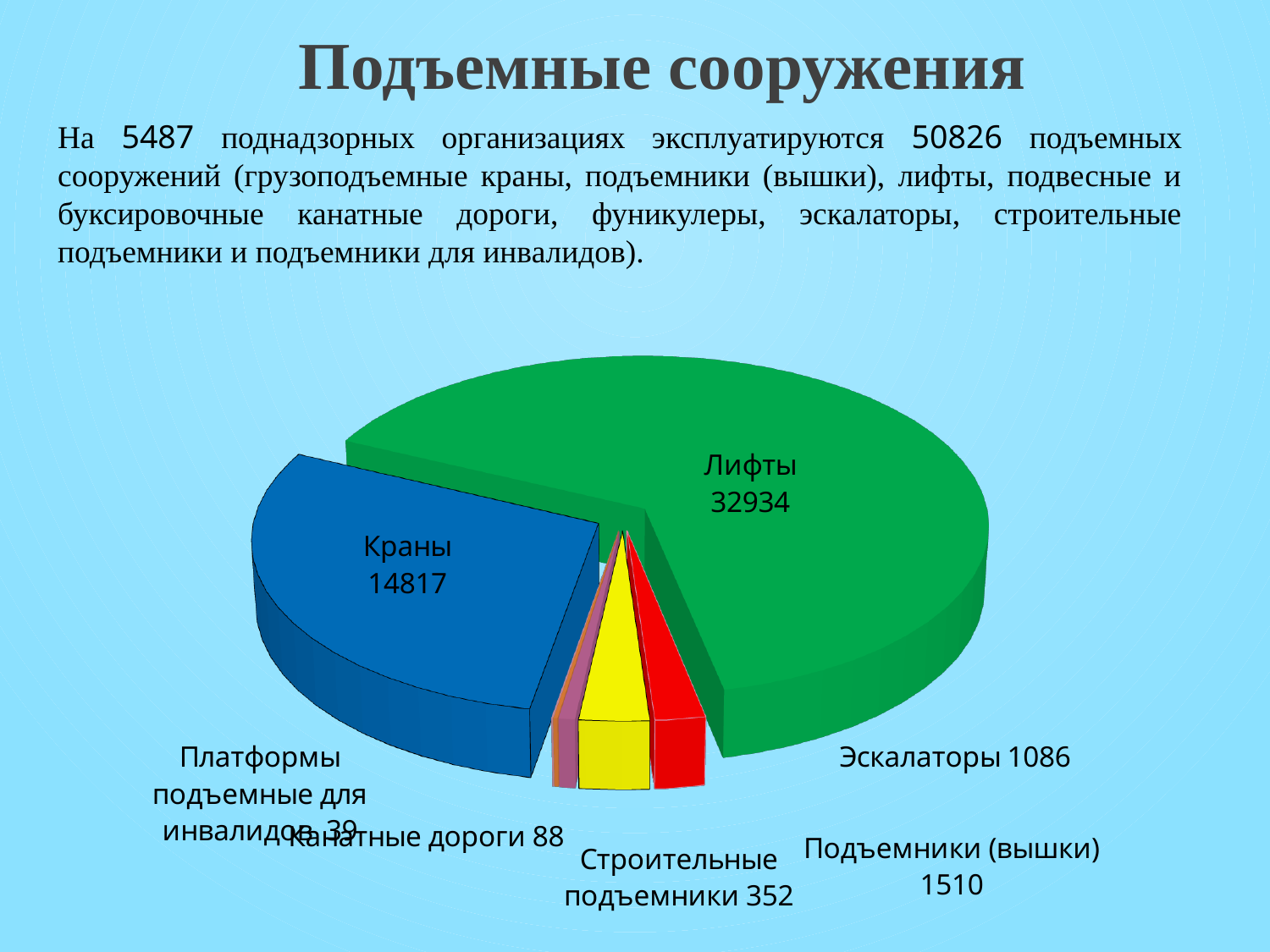
How many categories does the pie chart show? 7 Which is larger, Эскалаторы or Подъемники (вышки)? Подъемники (вышки) What colour is the Лифты slice? green What is the value for Строительные подъемники? 352 Which category has the largest slice of the pie? Лифты What is the value for Подъемники (вышки)? 1510 What is the value for Эскалаторы? 1086 What is the value for Лифты? 32934 What is the value for Краны? 14817 What kind of chart is shown on the slide? pie chart What is the difference between the values for Лифты and Краны? 18117 Which category has the smallest value? Платформы подъемные для инвалидов